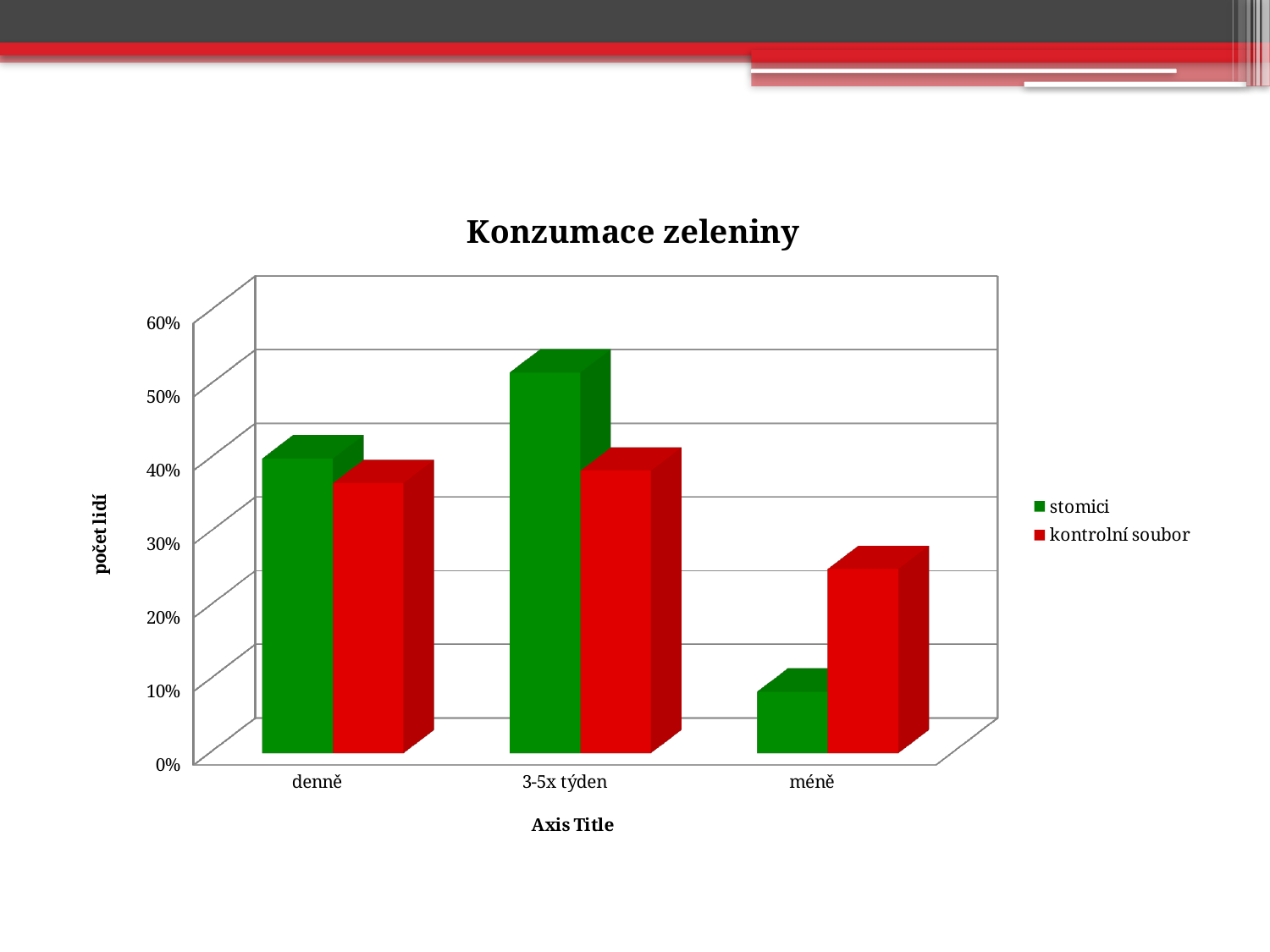
Is the value for stomici in the category 3-5x týden greater or less than 40%? greater What is the title of the chart? Konzumace zeleniny How many categories are shown on the x axis? 3 Which category has the lowest value for the kontrolní soubor series? méně Is the value for stomici in the category méně greater or less than 20%? less What is the label of the vertical axis? počet lidí For the category 3-5x týden, which series has the larger value, stomici or kontrolní soubor? stomici What kind of chart is shown on the slide? bar chart Which category has the highest value for the stomici series? 3-5x týden Which category has the lowest value for the stomici series? méně For the category méně, which series has the larger value, stomici or kontrolní soubor? kontrolní soubor How many series does the legend list? 2